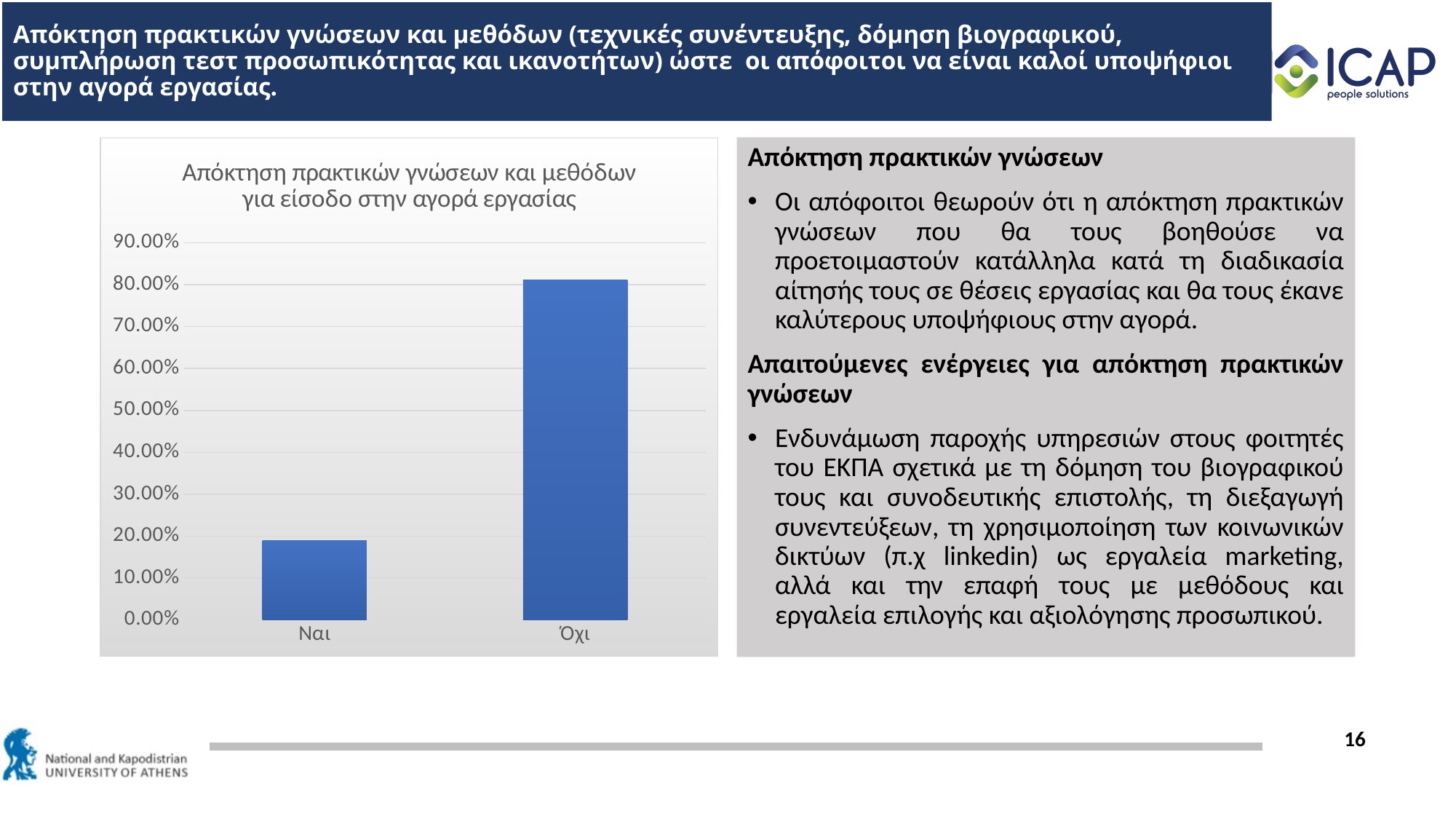
Is the value for Όχι greater or less than 90.00%? less Which is larger, the value for Ναι or the value for Όχι? Όχι What type of chart is shown on the slide? Bar chart Is the value for Ναι greater or less than 30.00%? less Is the value for Ναι greater or less than 10.00%? greater What is the highest value shown on the chart's y axis? 90.00% What is the title of the chart? Απόκτηση πρακτικών γνώσεων και μεθόδων για είσοδο στην αγορά εργασίας Which category has the highest value in the chart? Όχι Which category has the lowest value in the chart? Ναι How many categories are shown on the x axis of the chart? 2